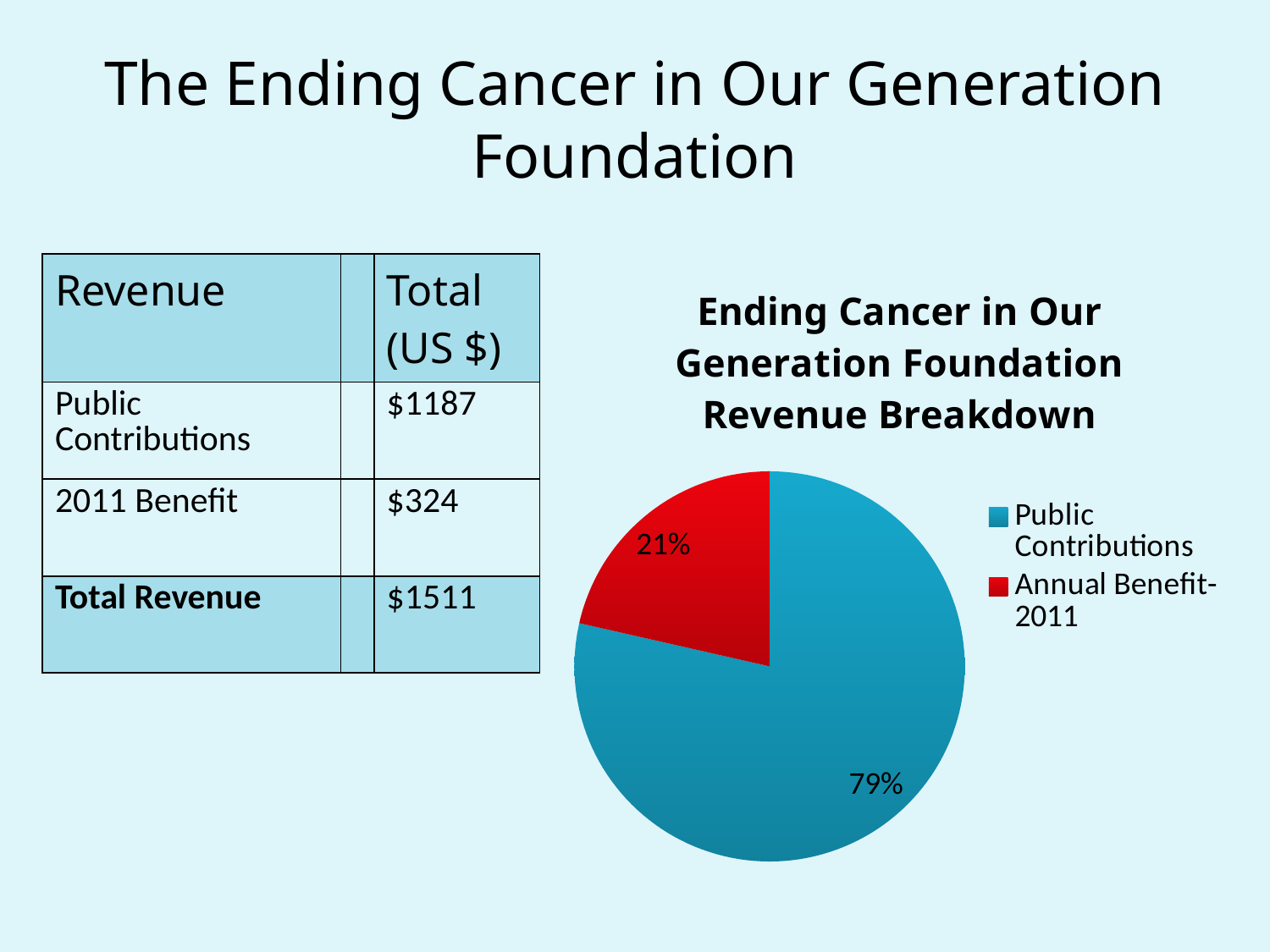
Is the share for Annual Benefit-2011 greater or less than 50%? less How many slices does the pie chart have? 2 What colour is the Annual Benefit-2011 slice? red Which slice of the pie is the smallest? Annual Benefit-2011 What is the title of the chart? Ending Cancer in Our Generation Foundation Revenue Breakdown How many entries does the legend list? 2 What kind of chart is shown on the slide? pie chart Which slice of the pie is the largest? Public Contributions What is the difference in percentage points between the Public Contributions slice and the Annual Benefit-2011 slice? 58 What share of the pie does Public Contributions represent? 79% Which is larger, the Public Contributions slice or the Annual Benefit-2011 slice? Public Contributions What share of the pie does Annual Benefit-2011 represent? 21%